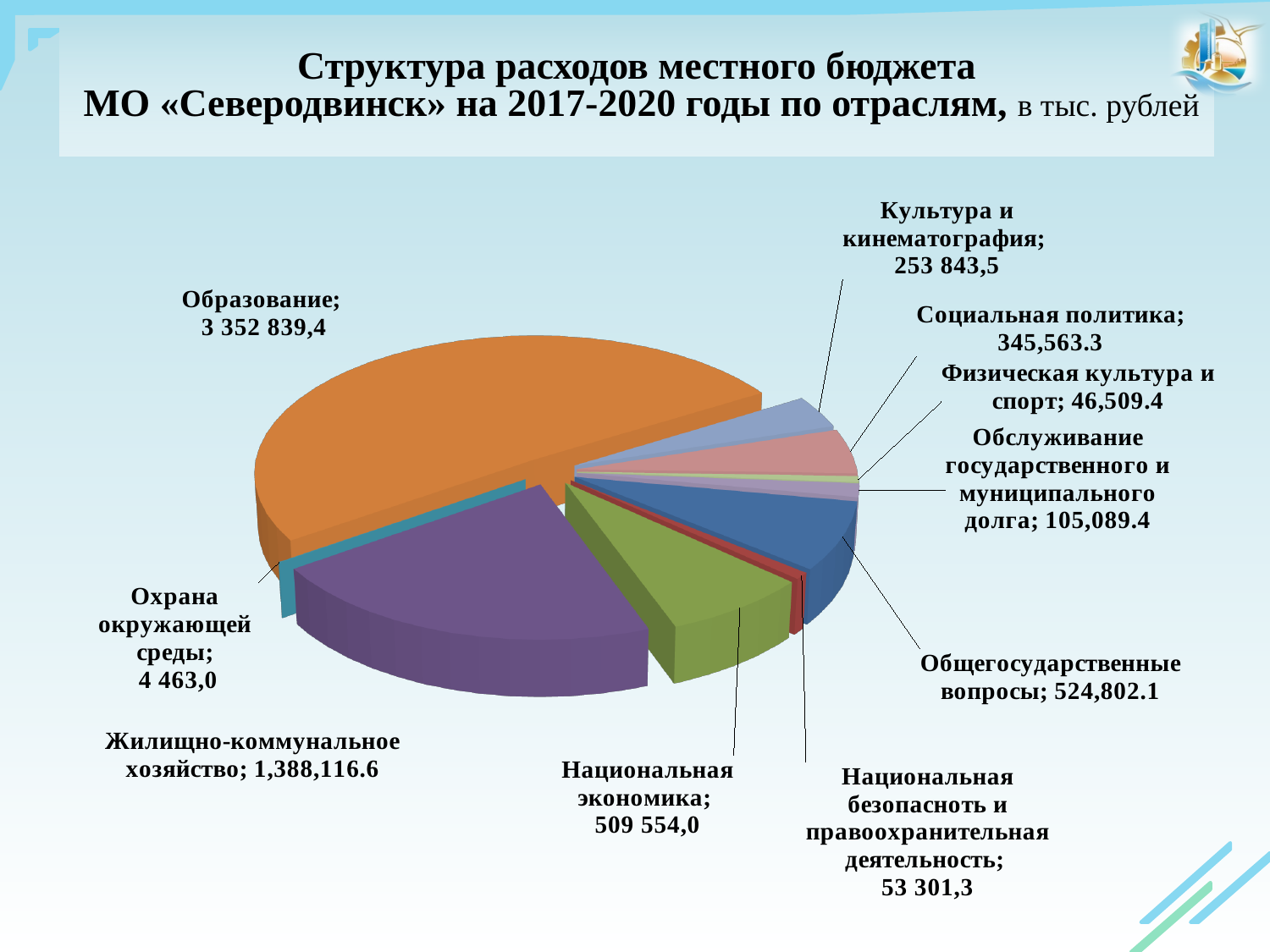
Which category has the largest value? Образование What is the value for Жилищно-коммунальное хозяйство? 1,388,116.6 In what units are the values on the chart given, according to the title? тыс. рублей Which category has the smallest value? Охрана окружающей среды Which is larger: Жилищно-коммунальное хозяйство or Национальная экономика? Жилищно-коммунальное хозяйство What is the value for Образование? 3 352 839,4 What is the difference between the values for Культура и кинематография and Национальная безопасность и правоохранительная деятельность? 200 542,2 How many categories (sectors) does the pie chart show? 10 What is the value for Обслуживание государственного и муниципального долга? 105,089.4 What kind of chart is shown on the slide? Pie chart What is the value for Физическая культура и спорт? 46,509.4 What is the value for Национальная безопасность и правоохранительная деятельность? 53 301,3